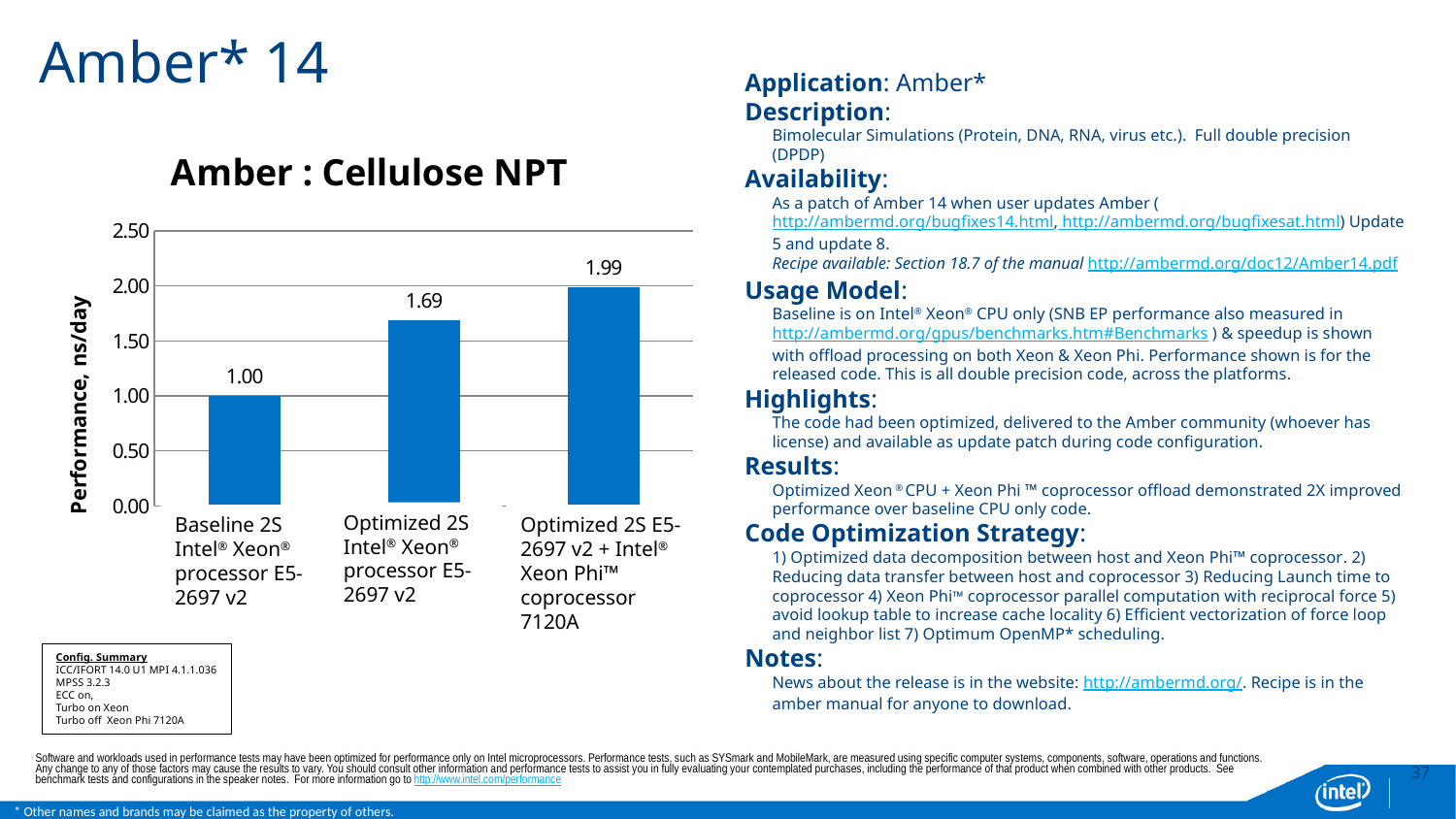
How many categories are shown on the chart? 3 What is the performance value for Optimized 2S Intel Xeon processor E5-2697 v2? 1.69 Which has a higher performance value: Optimized 2S Intel Xeon processor E5-2697 v2 or Optimized 2S E5-2697 v2 + Intel Xeon Phi coprocessor 7120A? Optimized 2S E5-2697 v2 + Intel Xeon Phi coprocessor 7120A What type of chart is shown on the slide? Bar chart What is the difference in performance between the Optimized 2S Intel Xeon processor E5-2697 v2 and the Baseline 2S Intel Xeon processor E5-2697 v2? 0.69 Is the value for Optimized 2S Intel Xeon processor E5-2697 v2 greater or less than 1.50? greater What is the performance value for Optimized 2S E5-2697 v2 + Intel Xeon Phi coprocessor 7120A? 1.99 What is the title of the chart? Amber : Cellulose NPT What is the difference in performance between the Optimized 2S E5-2697 v2 + Xeon Phi 7120A configuration and the Baseline 2S configuration? 0.99 Which category has the highest performance? Optimized 2S E5-2697 v2 + Intel Xeon Phi coprocessor 7120A Which category has the lowest performance? Baseline 2S Intel Xeon processor E5-2697 v2 What is the performance value for Baseline 2S Intel Xeon processor E5-2697 v2? 1.00